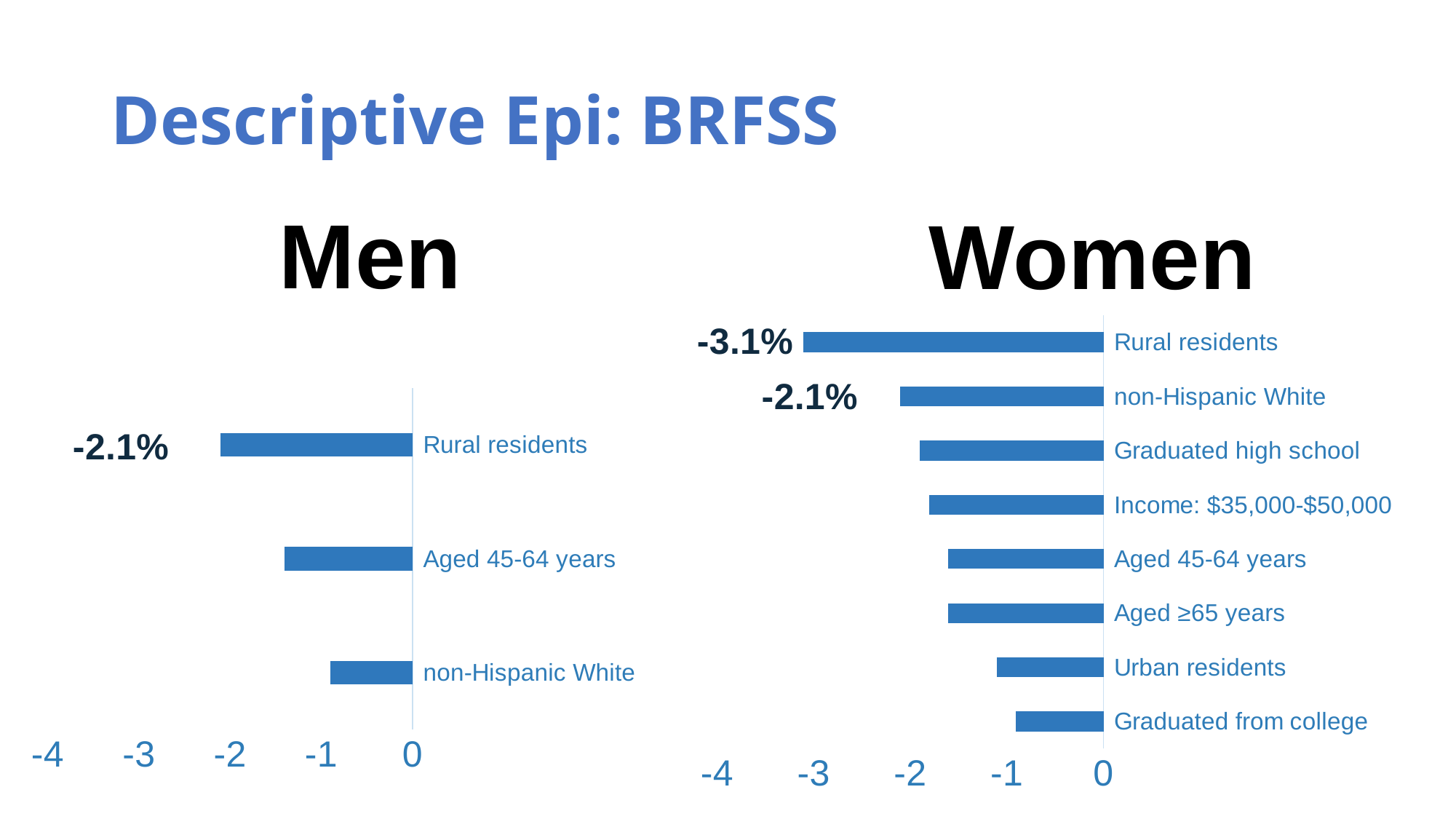
What kind of chart is the Women chart? Bar chart In the Women chart, which category has the longest bar (largest decrease)? Rural residents How many categories are plotted in the Women chart? 8 In the Women chart, what is the value shown for non-Hispanic White? -2.1% In the Women chart, is the value for Graduated from college greater or less than -2? greater In the Men chart, what is the value shown for Rural residents? -2.1% What is the difference between the Rural residents value in the Women chart (-3.1%) and the non-Hispanic White value in the Women chart (-2.1%)? 1.0 percentage point Which chart shows a larger decrease for Rural residents, the Men chart or the Women chart? Women In the Women chart, what is the value shown for Rural residents? -3.1% In the Men chart, is the value for Aged 45-64 years greater or less than -2? greater How many categories are plotted in the Men chart? 3 In the Men chart, which category has the shortest bar (smallest decrease)? non-Hispanic White